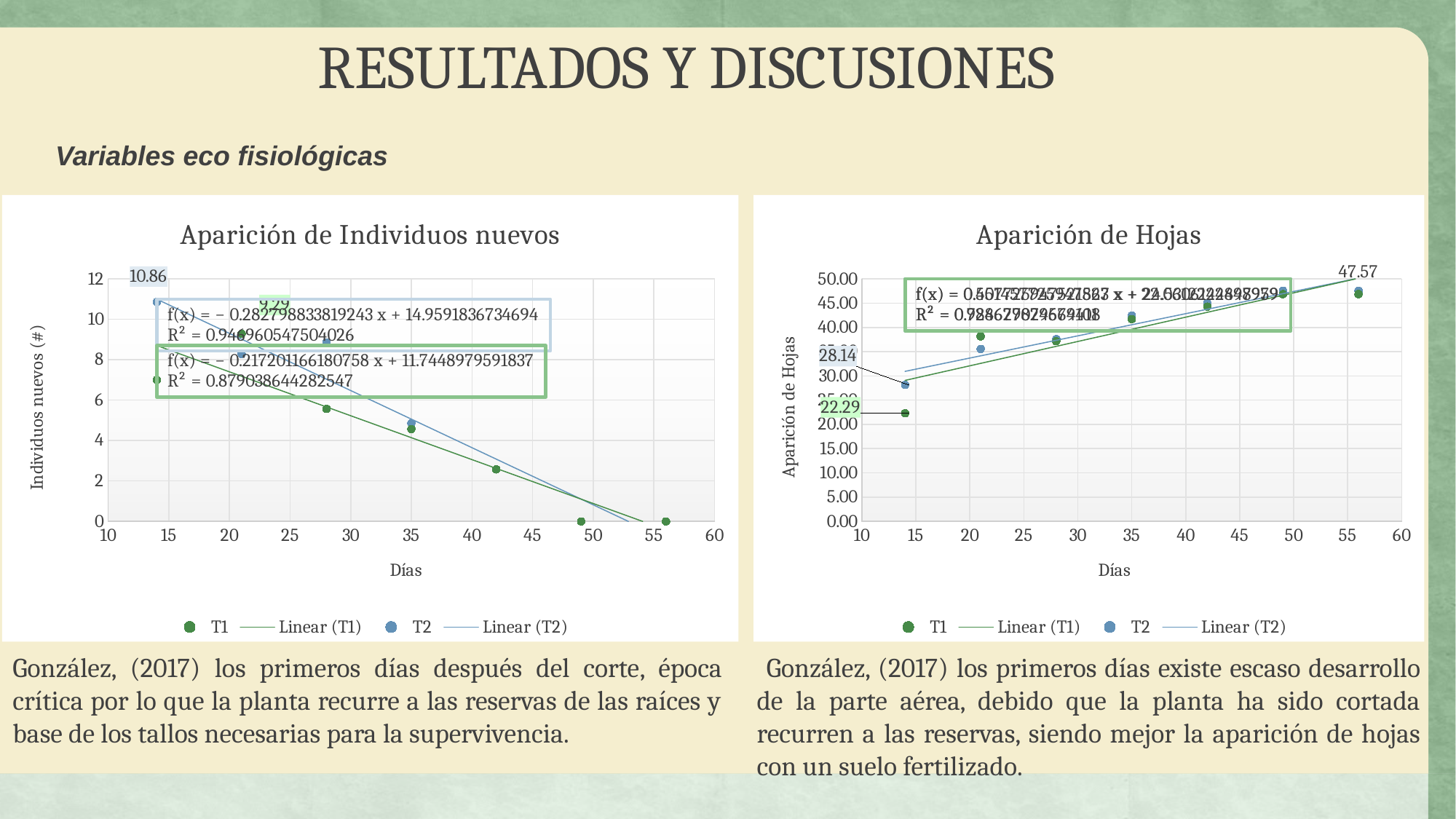
In the 'Aparición de Individuos nuevos' chart, is the T1 value at day 28 greater or less than 4? greater In the 'Aparición de Hojas' chart, which series has the larger value at day 14, T1 or T2? T2 In the 'Aparición de Hojas' chart, what is the labelled value for T2 at day 14? 28.14 In the 'Aparición de Individuos nuevos' chart, what is the labelled value for T2 at day 14? 10.86 How many entries does the legend of the 'Aparición de Hojas' chart list? 4 In the 'Aparición de Individuos nuevos' chart, do the values rise or fall as the days increase? Fall In the 'Aparición de Hojas' chart, do the values rise or fall as the days increase? Rise What is the y-axis title of the 'Aparición de Individuos nuevos' chart? Individuos nuevos (#) In the 'Aparición de Hojas' chart, what is the labelled value for T1 at day 14? 22.29 What kind of chart is 'Aparición de Individuos nuevos'? Scatter chart with linear trendlines In the 'Aparición de Hojas' chart, what is the highest labelled value? 47.57 In the 'Aparición de Hojas' chart, what is the difference between the T2 and T1 values at day 14? 5.85